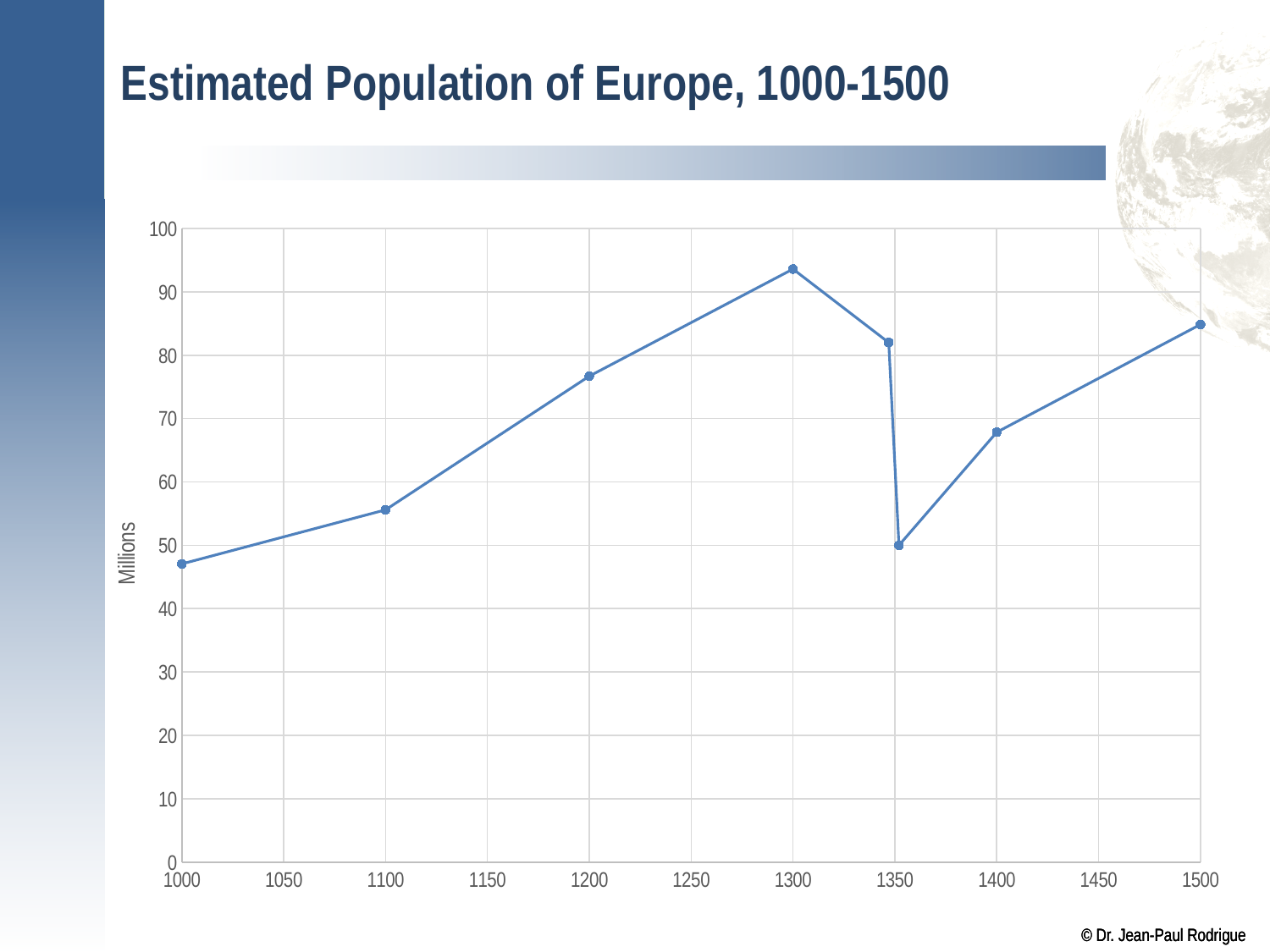
Is the value for the year 1400 greater or less than 70? less What is the title of the chart? Estimated Population of Europe, 1000-1500 Which year has the larger value, 1300 or 1500? 1300 What is the label on the vertical axis? Millions Does the population rise or fall between the years 1000 and 1300? rise Is the value for the year 1000 greater or less than 50? less How many data points are plotted on the line? 8 In which year does the plotted population reach its highest value? 1300 Is the value for the year 1300 greater or less than 90? greater What kind of chart is shown on the slide? line chart